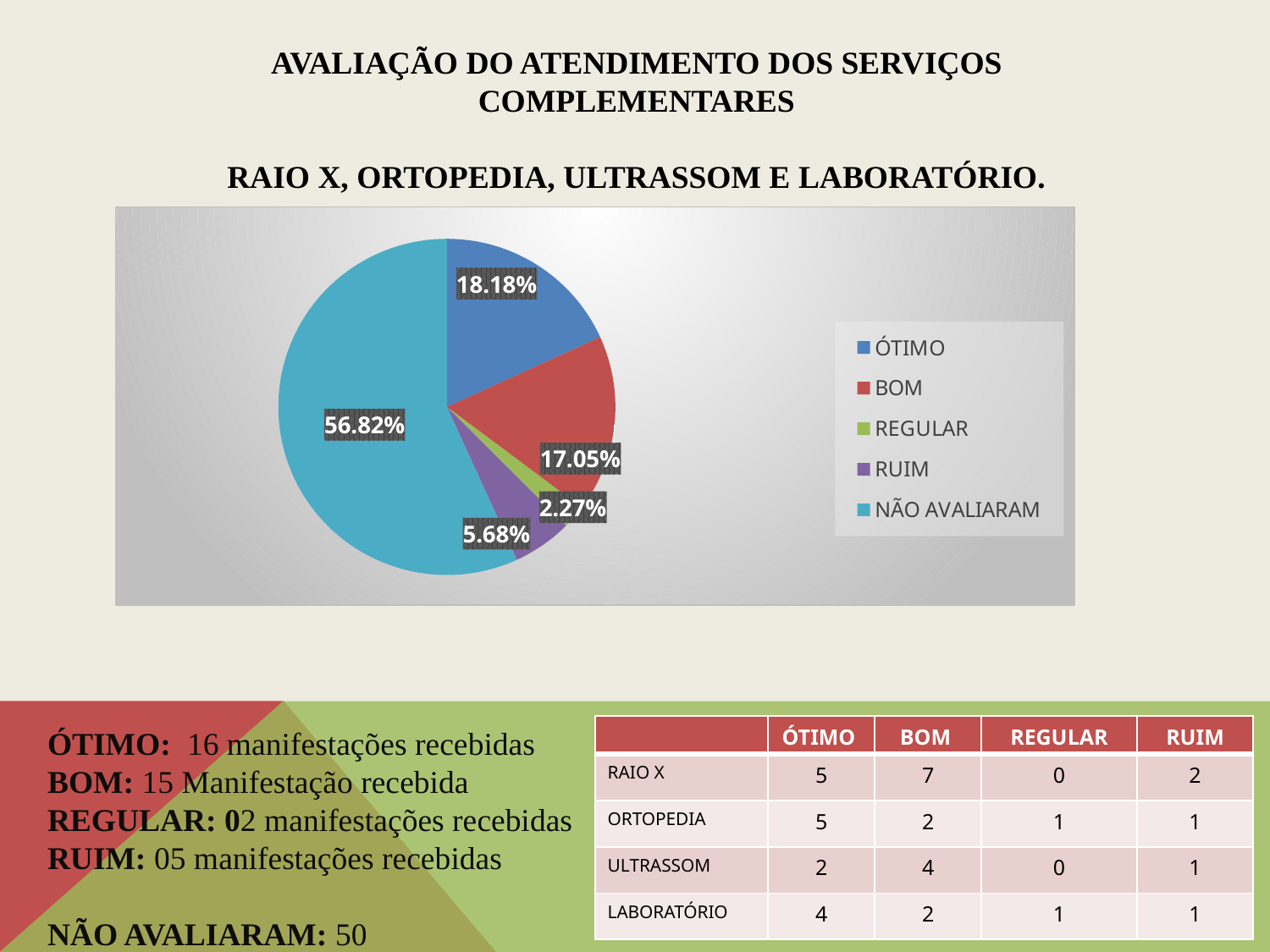
In the pie chart, what percentage is shown for RUIM? 5.68% In the pie chart, what percentage is shown for REGULAR? 2.27% In the pie chart, what percentage is shown for BOM? 17.05% In the pie chart, what percentage is shown for ÓTIMO? 18.18% In the pie chart, which slice is larger, ÓTIMO or BOM? ÓTIMO How many categories does the legend of the pie chart list? 5 In the pie chart, what is the difference in percentage points between NÃO AVALIARAM and ÓTIMO? 38.64% In the pie chart, what percentage is shown for NÃO AVALIARAM? 56.82% What kind of chart is shown on the slide? pie chart Which category has the smallest slice in the pie chart? REGULAR What colour is the NÃO AVALIARAM slice in the pie chart? light blue (teal) Which category has the largest slice in the pie chart? NÃO AVALIARAM